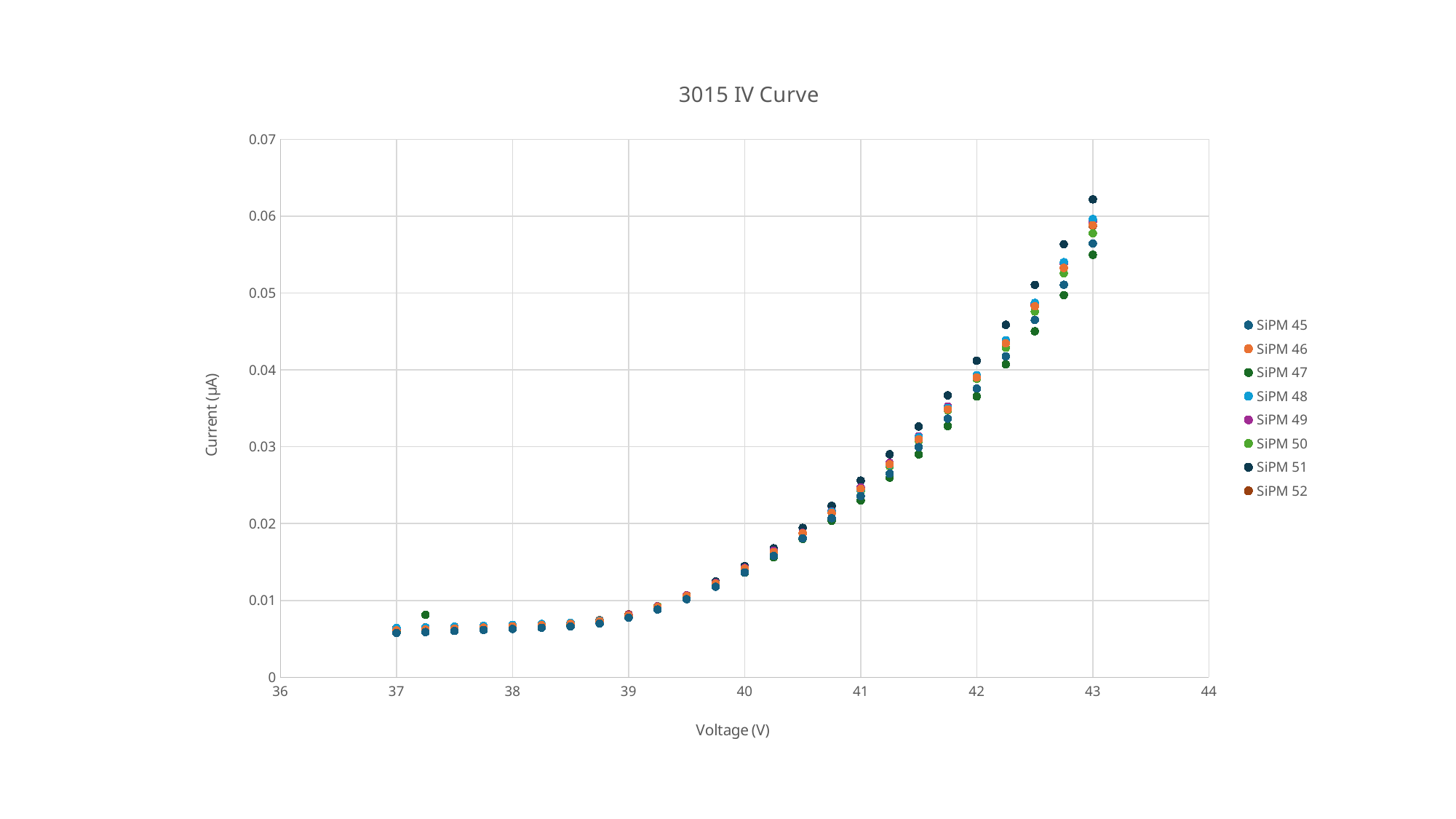
Is the current for SiPM 51 at 42 V greater or less than 0.04? greater Is the current for SiPM 45 at 40 V greater or less than 0.02? less Which series has the lowest current at 43 V? SiPM 47 Which is larger at 42.5 V: the current for SiPM 51 or the current for SiPM 47? SiPM 51 Do the current values rise or fall as voltage increases from 39 V to 43 V? rise How many series does the legend list? 8 Is the current for SiPM 51 at 43 V greater or less than 0.06? greater What is the title of the chart? 3015 IV Curve Which series has the highest current at 43 V? SiPM 51 What is the label of the y axis? Current (µA) What kind of chart is shown on the slide? scatter chart